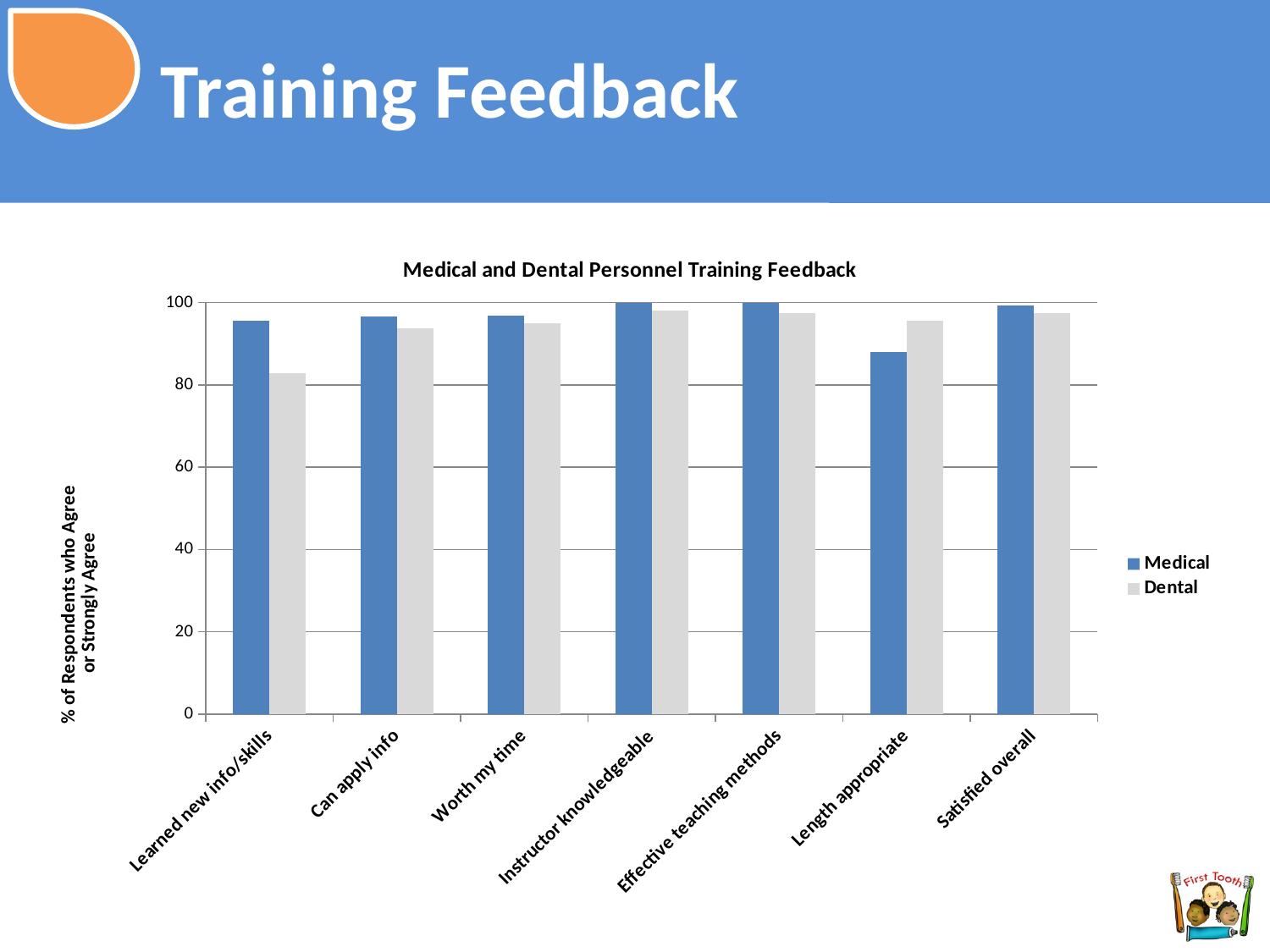
For 'Length appropriate', which is larger, the Medical or the Dental value? Dental What is the title of the chart? Medical and Dental Personnel Training Feedback For 'Learned new info/skills', which is larger, the Medical or the Dental value? Medical Is the Dental value for 'Learned new info/skills' greater or less than 90? less What kind of chart is shown on the slide? bar chart What is the label on the vertical axis? % of Respondents who Agree or Strongly Agree Is the Medical value for 'Length appropriate' greater or less than 80? greater How many series does the legend list? 2 For which category is the Medical value lowest? Length appropriate For which category is the Dental value lowest? Learned new info/skills Is the Dental value for 'Length appropriate' greater or less than 90? greater How many categories are shown on the x axis? 7